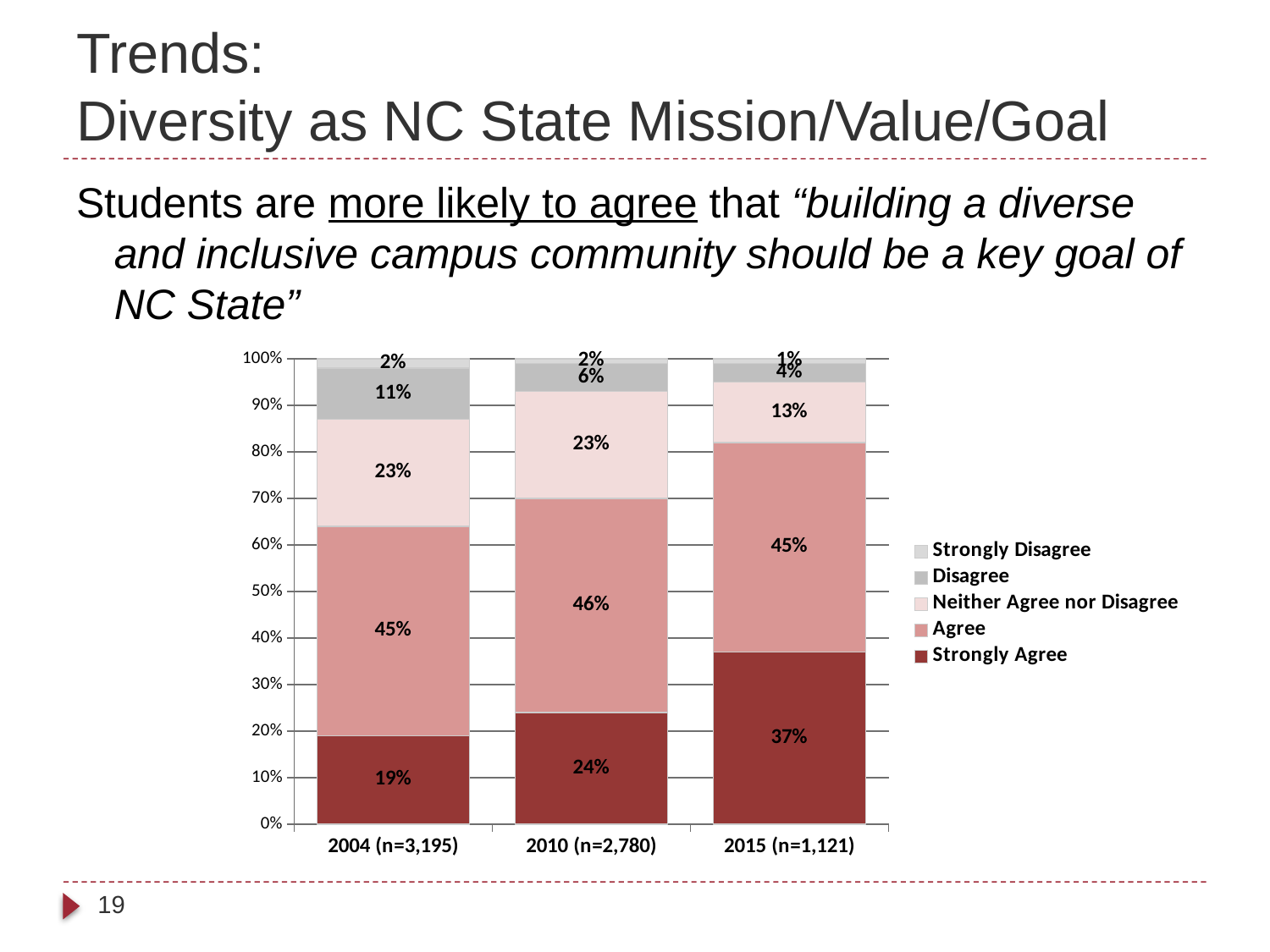
What kind of chart is shown on the slide? Stacked bar chart Which year has the lowest Disagree percentage? 2015 (n=1,121) By how many percentage points did Strongly Agree increase from 2004 (n=3,195) to 2015 (n=1,121)? 18 What is the Disagree value for 2004 (n=3,195)? 11% What percentage of students in 2015 (n=1,121) selected Strongly Agree? 37% What is the Agree value for 2010 (n=2,780)? 46% How many years (categories) are shown on the x axis? 3 How many series does the legend list? 5 What is the Neither Agree nor Disagree value for 2015 (n=1,121)? 13% What percentage of students in 2004 (n=3,195) selected Strongly Agree? 19% Which year has the highest Strongly Agree percentage? 2015 (n=1,121) Is the Neither Agree nor Disagree value larger in 2004 (n=3,195) or in 2015 (n=1,121)? 2004 (n=3,195)